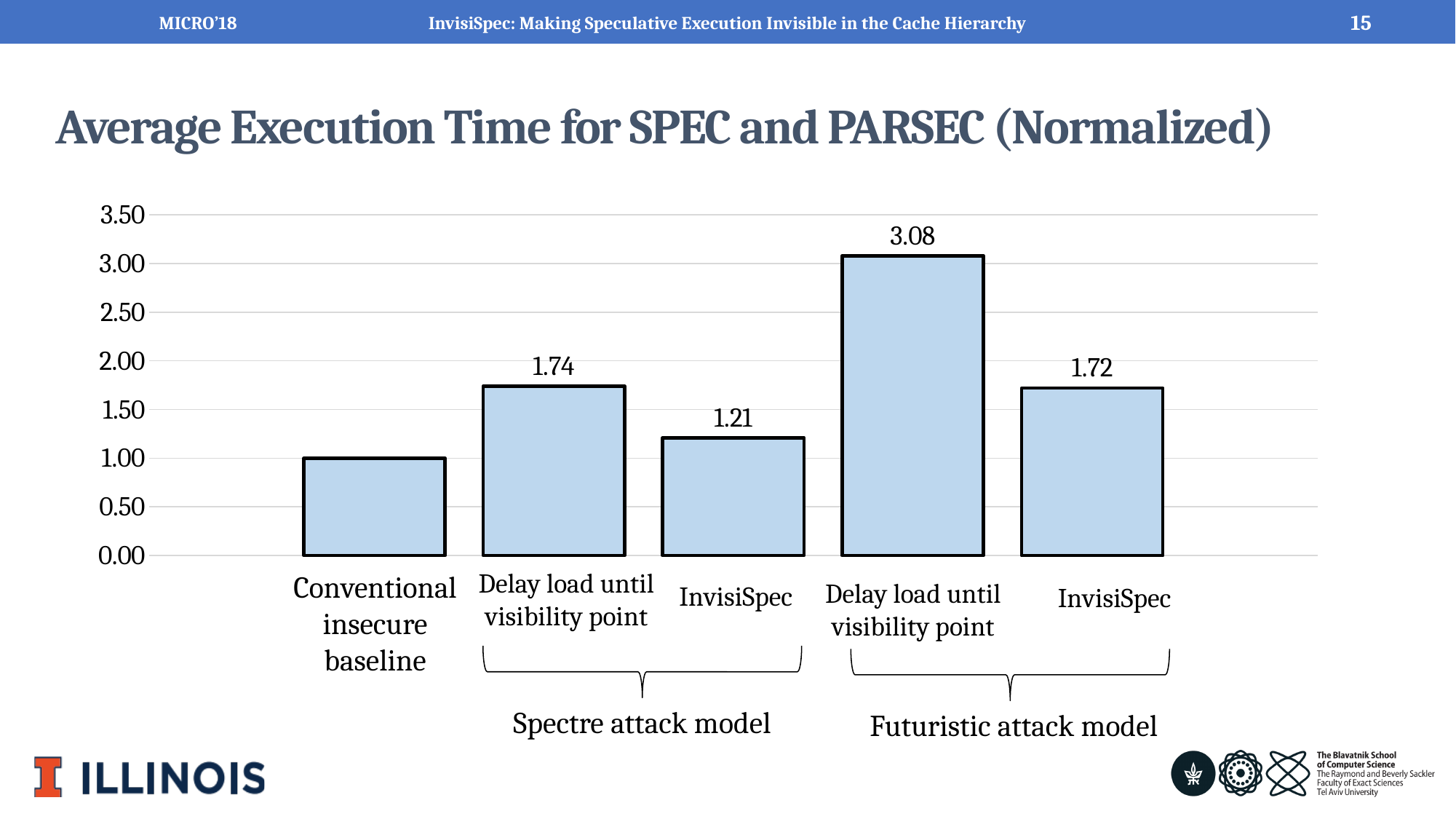
Which bar has the highest normalized execution time? Delay load until visibility point (Futuristic attack model) What is the normalized execution time for InvisiSpec under the Futuristic attack model? 1.72 How many bars are shown in the chart? 5 What is the difference between 'Delay load until visibility point' and InvisiSpec under the Spectre attack model? 0.53 What is the normalized execution time for 'Delay load until visibility point' under the Futuristic attack model? 3.08 What type of chart is shown on the slide? Bar chart Which bar has the lowest normalized execution time? Conventional insecure baseline What is the normalized execution time for InvisiSpec under the Spectre attack model? 1.21 What is the normalized execution time for 'Delay load until visibility point' under the Spectre attack model? 1.74 What is the difference between 'Delay load until visibility point' and InvisiSpec under the Futuristic attack model? 1.36 Which is larger: InvisiSpec under the Spectre attack model or InvisiSpec under the Futuristic attack model? InvisiSpec under the Futuristic attack model What is the normalized execution time for the Conventional insecure baseline? 1.00